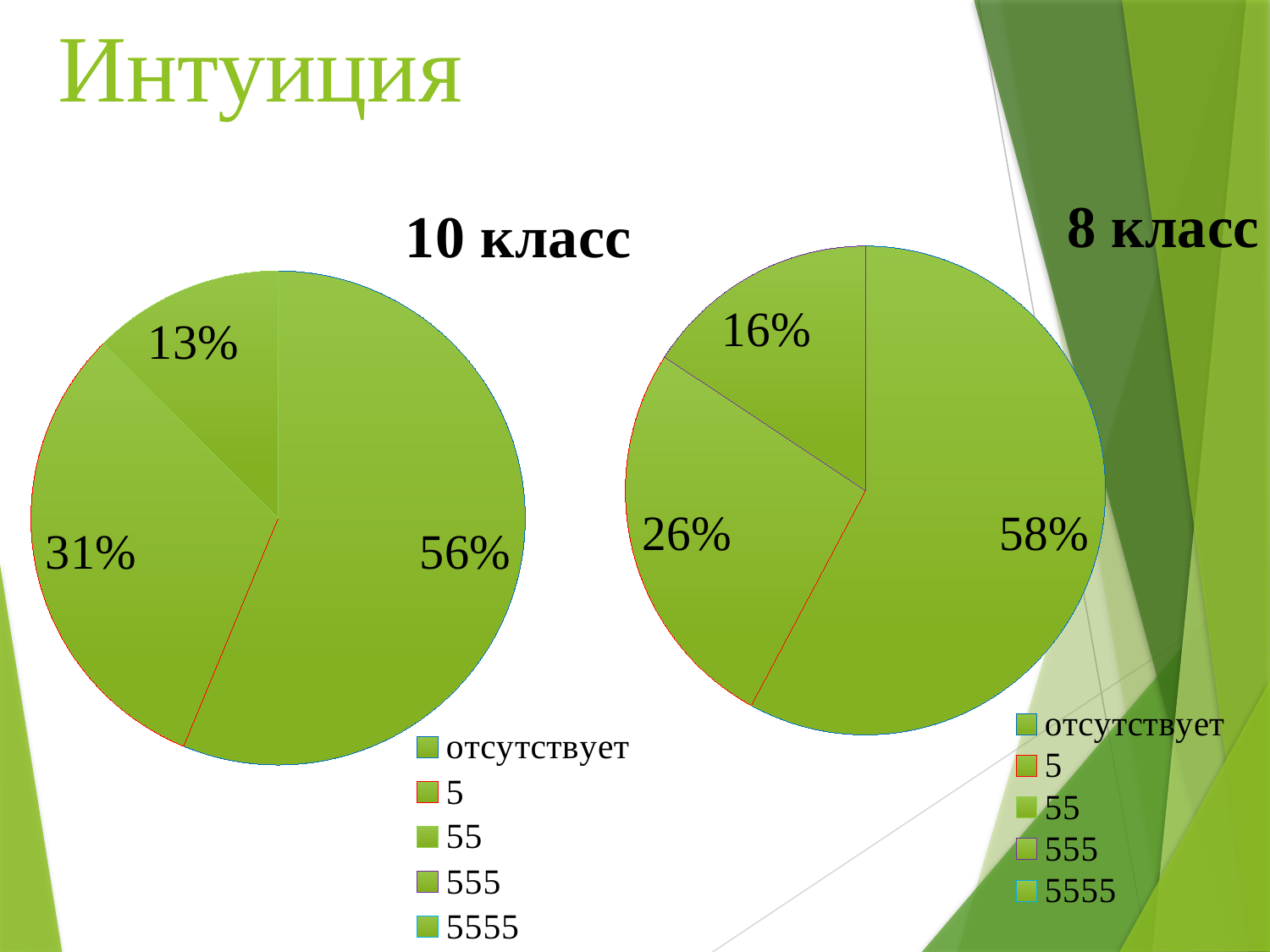
How many pie charts are shown on the slide? 2 How many entries does the legend of the "8 класс" pie chart list? 5 In the "10 класс" pie chart, what is the difference between the 56% slice and the 31% slice? 25 percentage points In the "8 класс" pie chart, what is the percentage of the smallest slice? 16% What kind of chart is used for the "10 класс" chart? Pie chart In the "8 класс" pie chart, what is the difference between the largest slice (58%) and the smallest slice (16%)? 42 percentage points In the "8 класс" pie chart, what is the percentage of the largest slice? 58% In the "10 класс" pie chart, what is the percentage of the smallest slice? 13% Which chart has the larger biggest slice, "10 класс" or "8 класс"? 8 класс In the "10 класс" pie chart, what is the percentage of the largest slice? 56% How many slices does the "10 класс" pie chart have? 3 What is the title of the slide containing the two pie charts? Интуиция